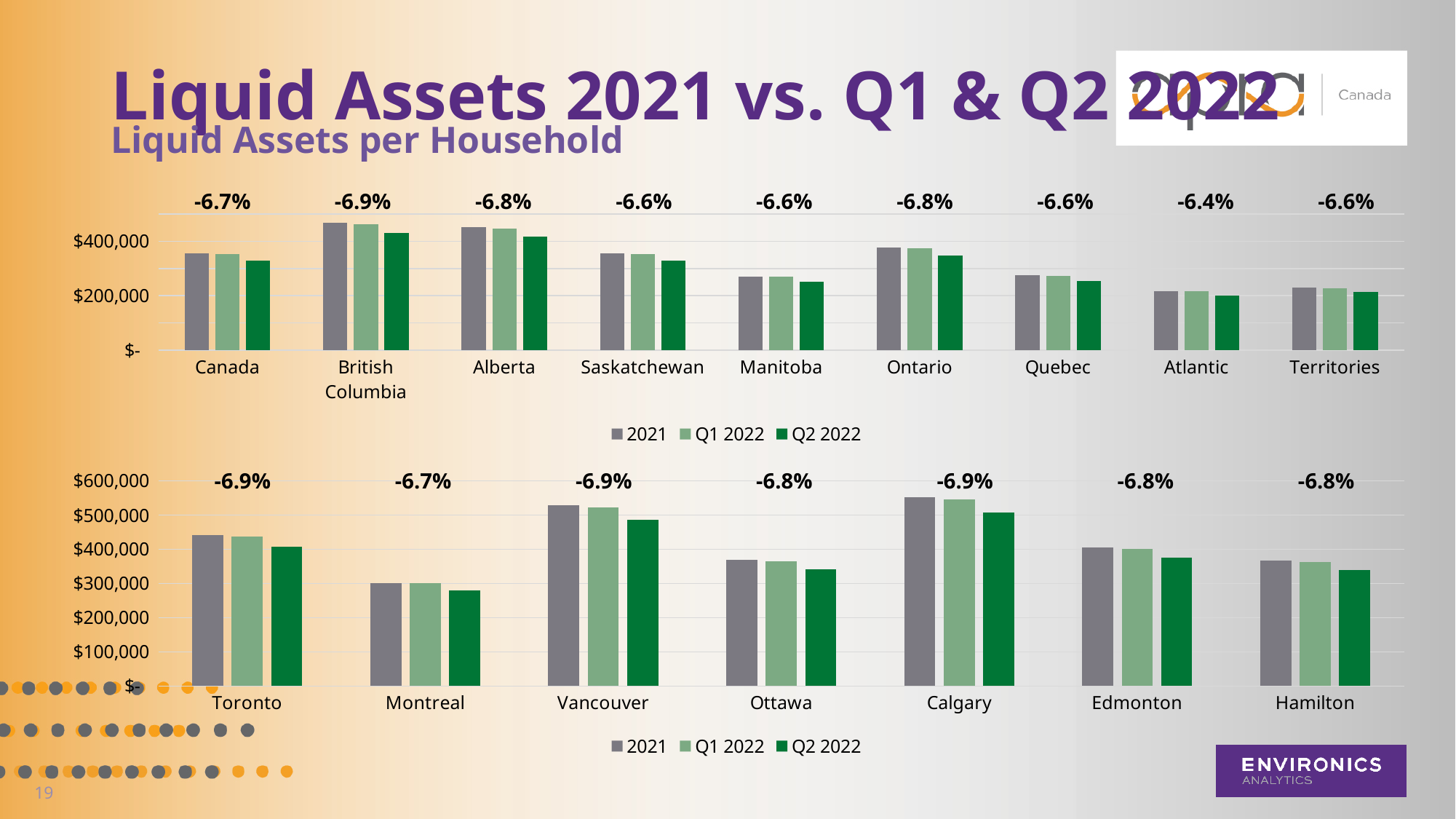
On the top chart (provinces), which is larger, the 2021 value for Ontario or the 2021 value for Quebec? Ontario On the top chart (provinces), what percentage change is shown above Atlantic? -6.4% On the top chart (provinces), is the 2021 value for British Columbia greater or less than $400,000? greater What kind of chart is the bottom chart (cities)? Bar chart On the bottom chart (cities), what percentage change is shown above Montreal? -6.7% On the bottom chart (cities), is the 2021 value for Calgary greater or less than $500,000? greater On the bottom chart (cities), is the Q2 2022 value for Montreal greater or less than $300,000? less On the bottom chart (cities), which city shows the smallest percentage decline? Montreal On the bottom chart (cities), how many series does the legend list? 3 On the top chart (provinces), how many categories are shown on the x axis? 9 On the bottom chart (cities), which city has the lowest 2021 value? Montreal On the top chart (provinces), what percentage change is shown above British Columbia? -6.9%